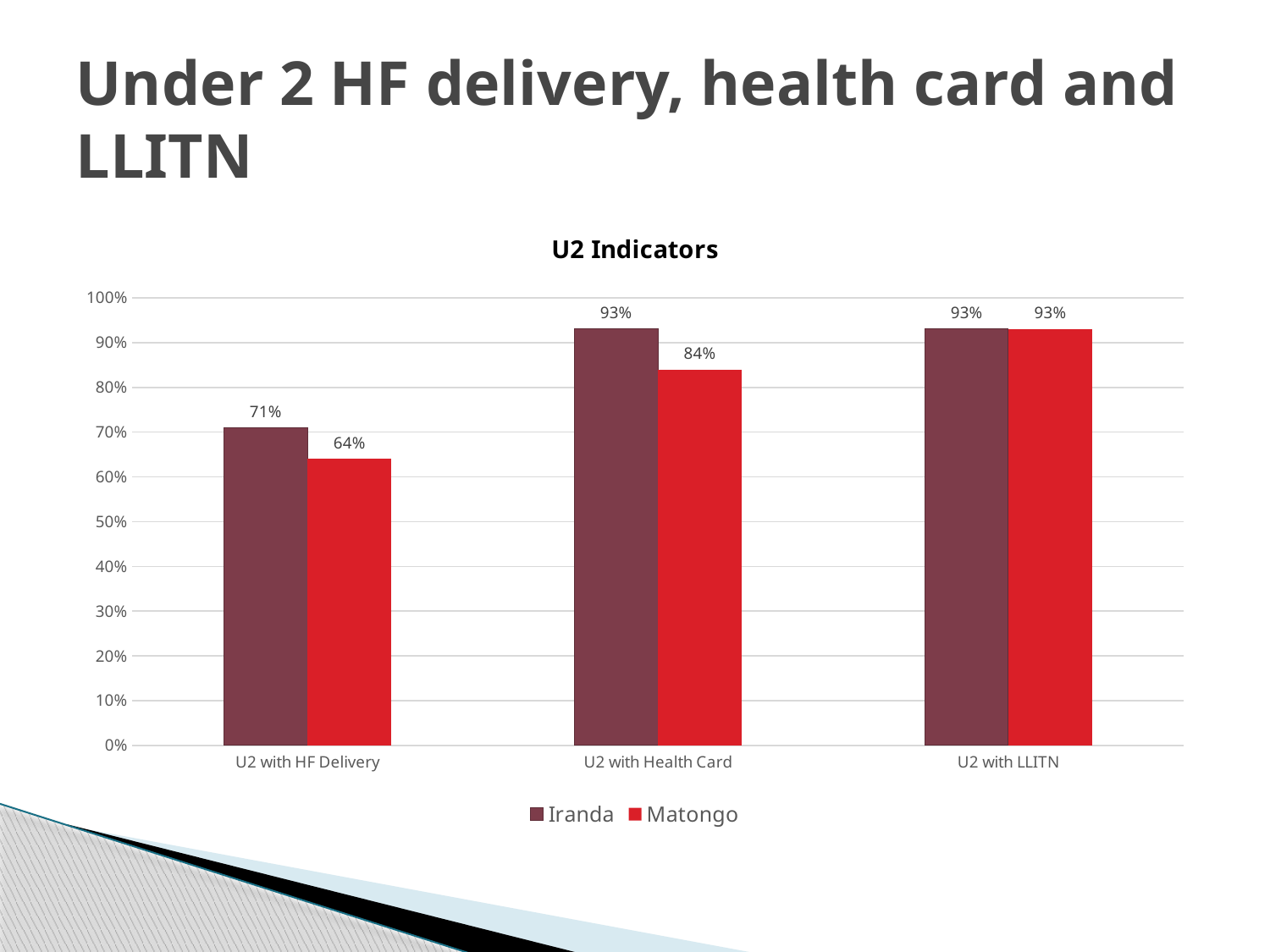
What is the value for Iranda for U2 with HF Delivery? 71% What is the value for Matongo for U2 with Health Card? 84% Is the value for Matongo for U2 with Health Card greater or less than 80%? greater Which is larger for U2 with HF Delivery, Iranda or Matongo? Iranda What is the difference between Iranda and Matongo for U2 with HF Delivery? 7% Which category has the lowest value for Matongo? U2 with HF Delivery Which category has the lowest value for Iranda? U2 with HF Delivery What is the value for Matongo for U2 with LLITN? 93% How many series does the legend list? 2 What kind of chart is shown? Bar chart What is the difference between Iranda and Matongo for U2 with Health Card? 9% How many categories are shown on the x axis? 3